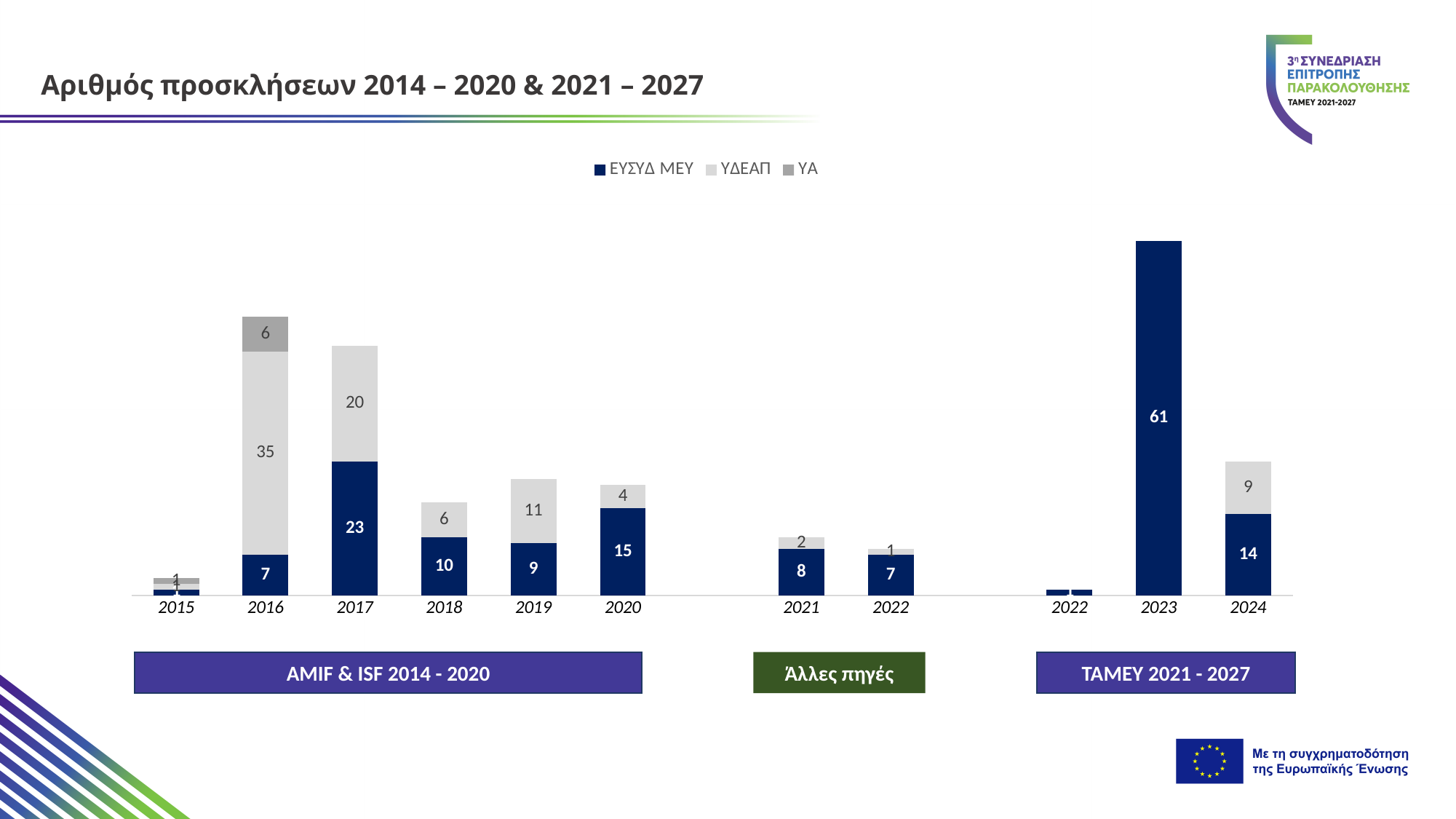
What is the value for ΥΑ in 2016? 6 What kind of chart is shown on the slide? Stacked bar chart What is the value for ΕΥΣΥΔ ΜΕΥ in 2023 (ΤΑΜΕΥ 2021 - 2027)? 61 Which year has the highest value for ΕΥΣΥΔ ΜΕΥ? 2023 In 2019, which is larger: ΕΥΣΥΔ ΜΕΥ or ΥΔΕΑΠ? ΥΔΕΑΠ What is the total of the stacked bar for 2024? 23 What is the value for ΥΔΕΑΠ in 2016? 35 What is the difference between ΕΥΣΥΔ ΜΕΥ and ΥΔΕΑΠ in 2017? 3 How many series does the legend list? 3 What is the value for ΥΔΕΑΠ in 2024? 9 What is the value for ΕΥΣΥΔ ΜΕΥ in 2017? 23 What is the total of the stacked bar for 2016? 48